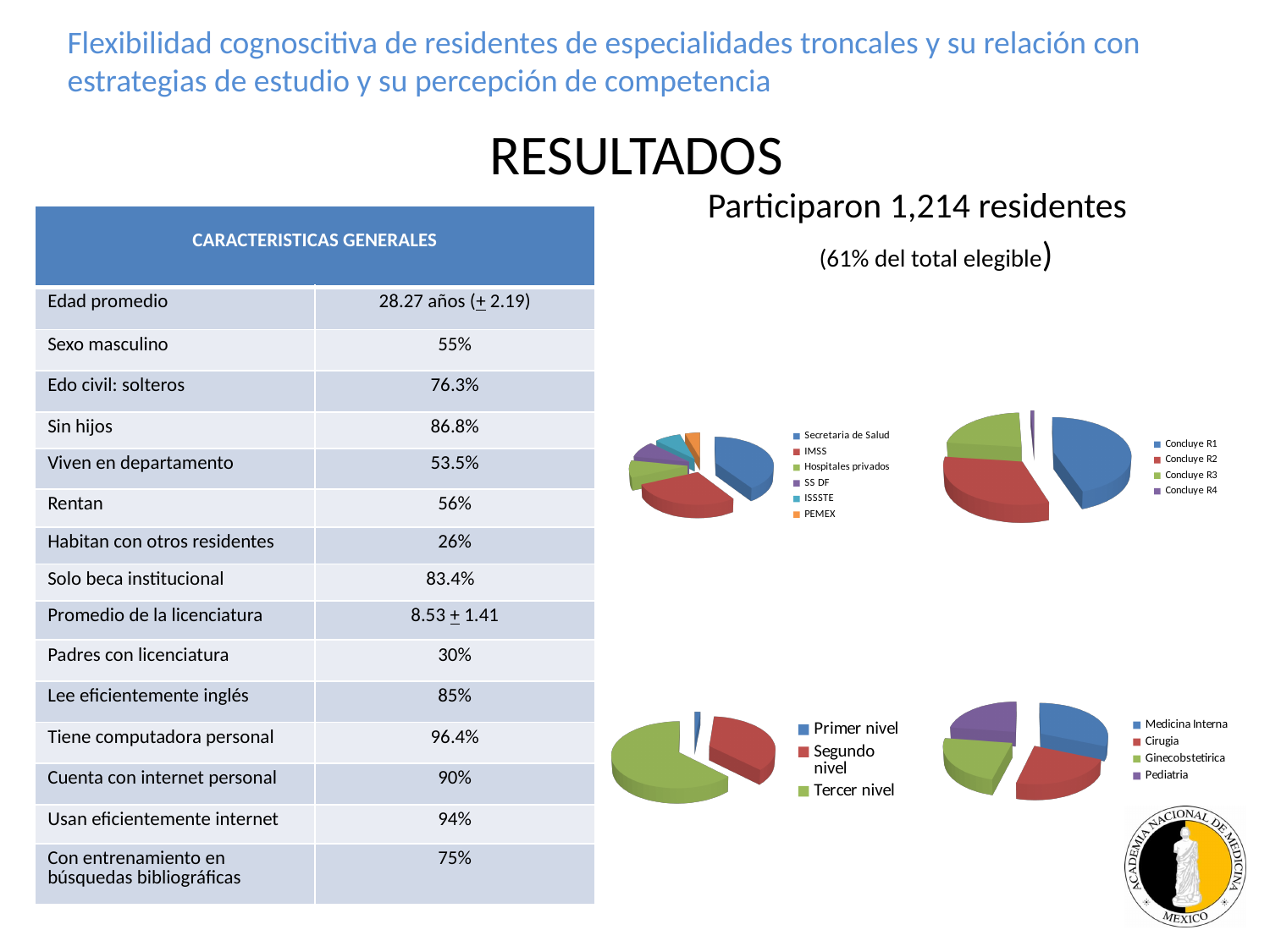
How many categories does the legend of the top-right pie chart (Concluye R1 to R4) list? 4 In the bottom-left pie chart (Primer nivel, Segundo nivel, Tercer nivel), which category has the largest slice? Tercer nivel In the top-right pie chart, which slice is larger: Concluye R1 or Concluye R4? Concluye R1 In the top-right pie chart (Concluye R1–R4), which category has the smallest slice? Concluye R4 In the bottom-left pie chart, which slice is larger: Segundo nivel or Primer nivel? Segundo nivel In the bottom-left pie chart (Primer nivel, Segundo nivel, Tercer nivel), which category has the smallest slice? Primer nivel In the top-right pie chart (Concluye R1–R4), which category has the largest slice? Concluye R1 How many categories does the legend of the bottom-left pie chart (Primer nivel, Segundo nivel, Tercer nivel) list? 3 How many categories does the legend of the top-left pie chart (Secretaria de Salud, IMSS, ...) list? 6 What kind of chart is the top-left chart on the slide (the one with the legend starting 'Secretaria de Salud')? Pie chart In the bottom-right pie chart, what colour is the slice for Pediatria? Purple